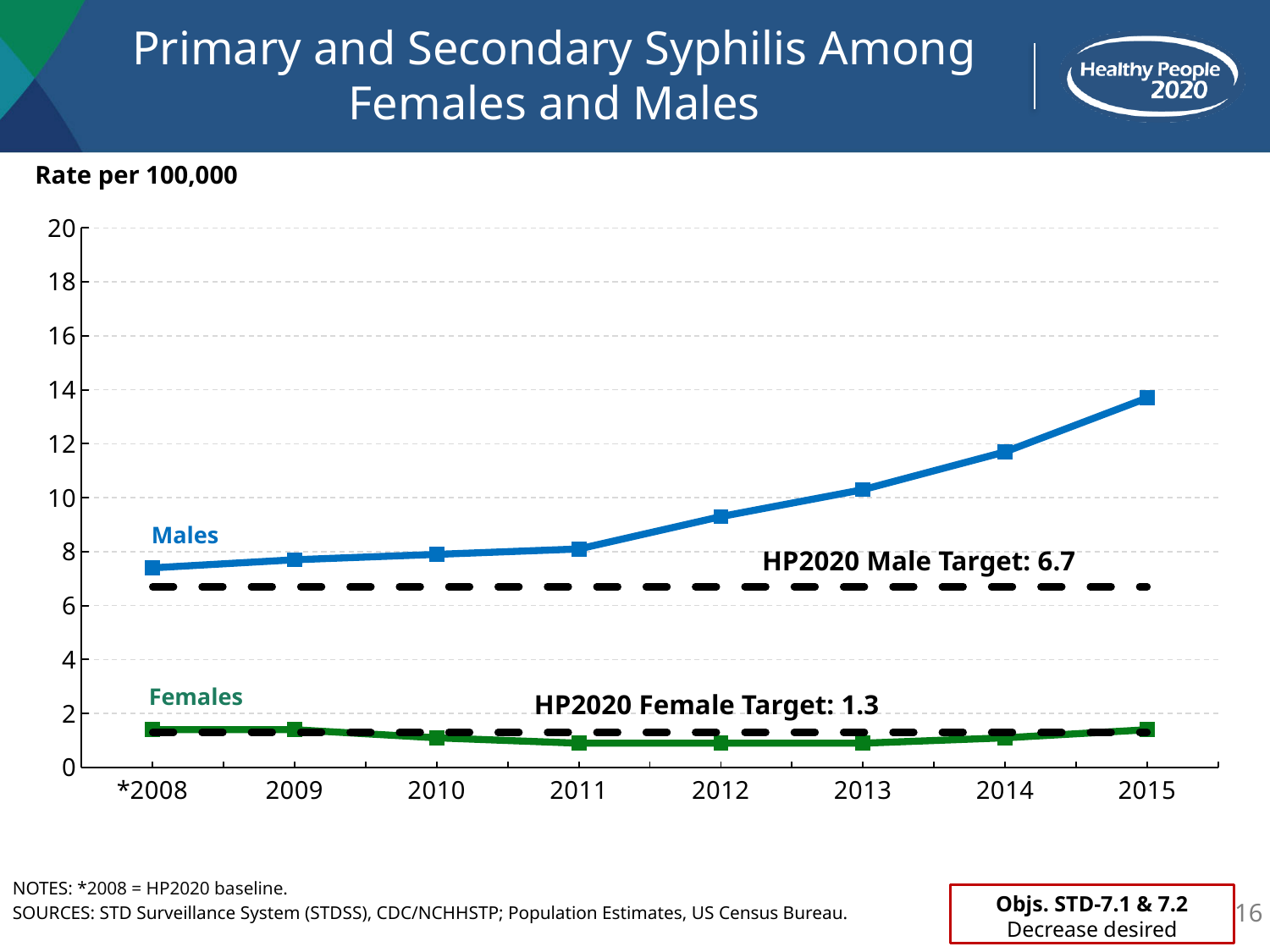
In which year is the rate for Males highest? 2015 How many years are plotted along the x axis? 8 Is the value for Males in 2015 greater or less than 12? greater Which group has the higher rate in 2015, Males or Females? Males Is the value for Males in 2014 greater or less than 10? greater What is the y-axis measure stated above the chart? Rate per 100,000 What kind of chart is shown on the slide? line chart Which year is marked with an asterisk as the HP2020 baseline? 2008 What is the HP2020 Female Target value shown on the chart? 1.3 Is the value for Females in 2011 greater or less than 2? less What is the HP2020 Male Target value shown on the chart? 6.7 Does the rate for Males rise or fall from 2008 to 2015? rise